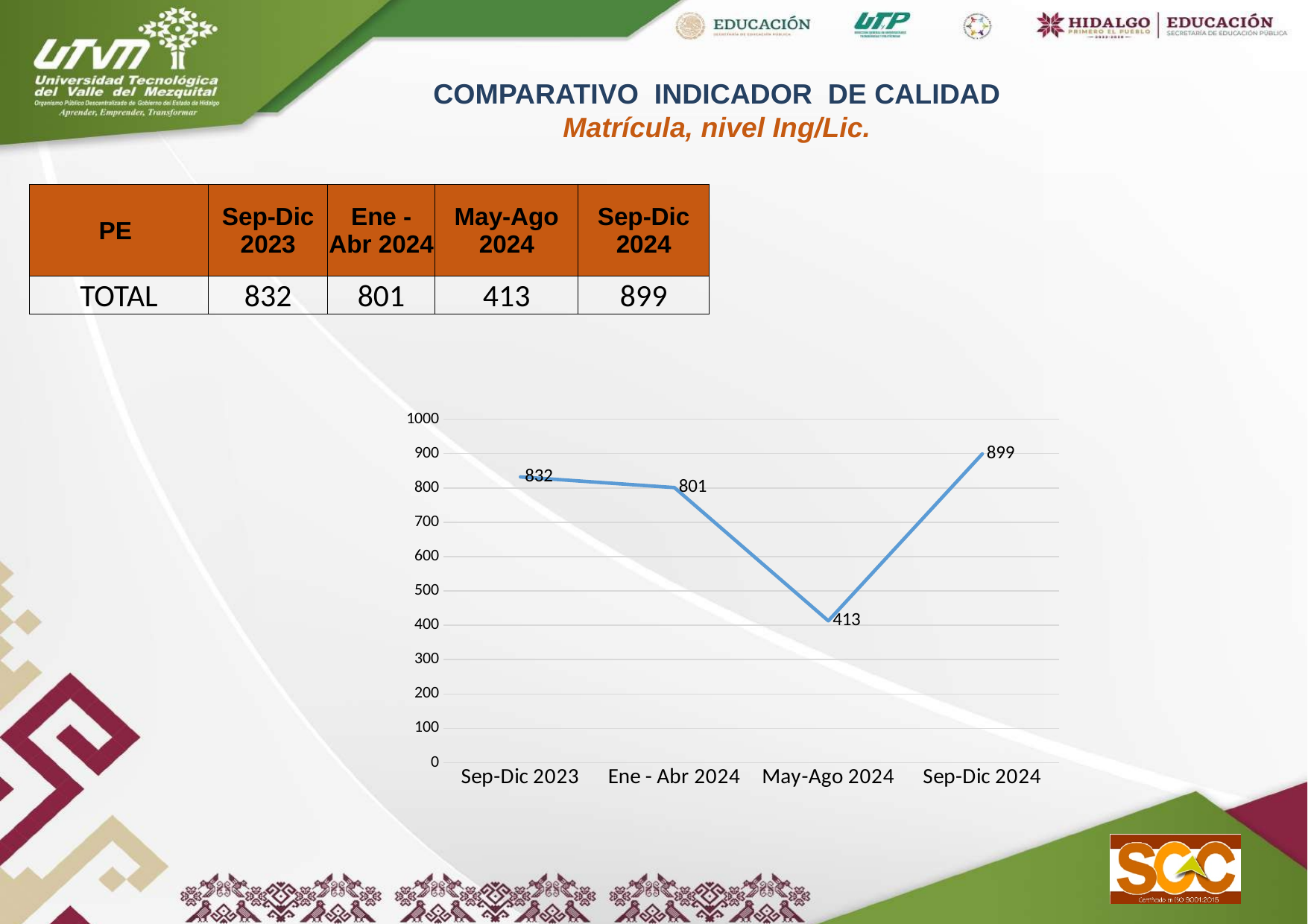
What is the value for May-Ago 2024 in the line chart? 413 What is the value for Ene - Abr 2024 in the line chart? 801 What is the difference between the values for Sep-Dic 2023 and Ene - Abr 2024? 31 Which period has the lowest value in the line chart? May-Ago 2024 What type of chart is shown on the slide? line chart What is the value for Sep-Dic 2023 in the line chart? 832 Which period has the highest value in the line chart? Sep-Dic 2024 Does the value rise or fall from May-Ago 2024 to Sep-Dic 2024? rise Which is larger, the value for Sep-Dic 2023 or the value for Sep-Dic 2024? Sep-Dic 2024 What is the value for Sep-Dic 2024 in the line chart? 899 How many periods are plotted on the x axis of the line chart? 4 What is the difference between the values for Sep-Dic 2024 and May-Ago 2024? 486